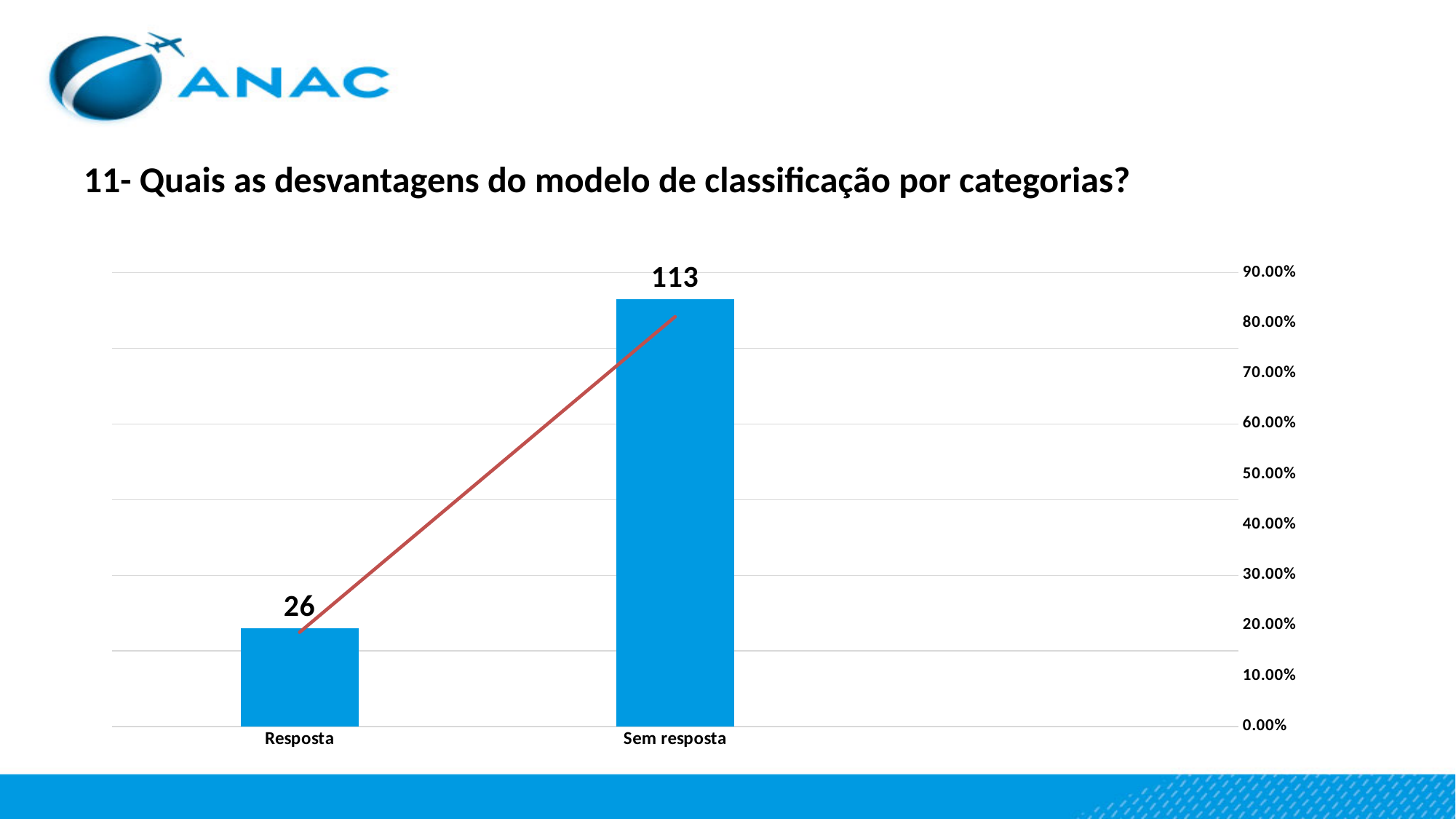
What is the value shown for Resposta? 26 Which is larger, the value for Resposta or the value for Sem resposta? Sem resposta What is the difference between the values for Sem resposta and Resposta? 87 Do the values rise or fall from Resposta to Sem resposta? Rise Which category has the highest value? Sem resposta What kind of chart is shown on the slide? Combination bar and line chart How many categories are shown on the x axis? 2 Which category has the lowest value? Resposta What is the value shown for Sem resposta? 113 What is the title of the chart on the slide? 11- Quais as desvantagens do modelo de classificação por categorias? On the percentage axis, is the bar for Sem resposta greater or less than 70.00%? greater On the percentage axis, is the bar for Resposta greater or less than 30.00%? less